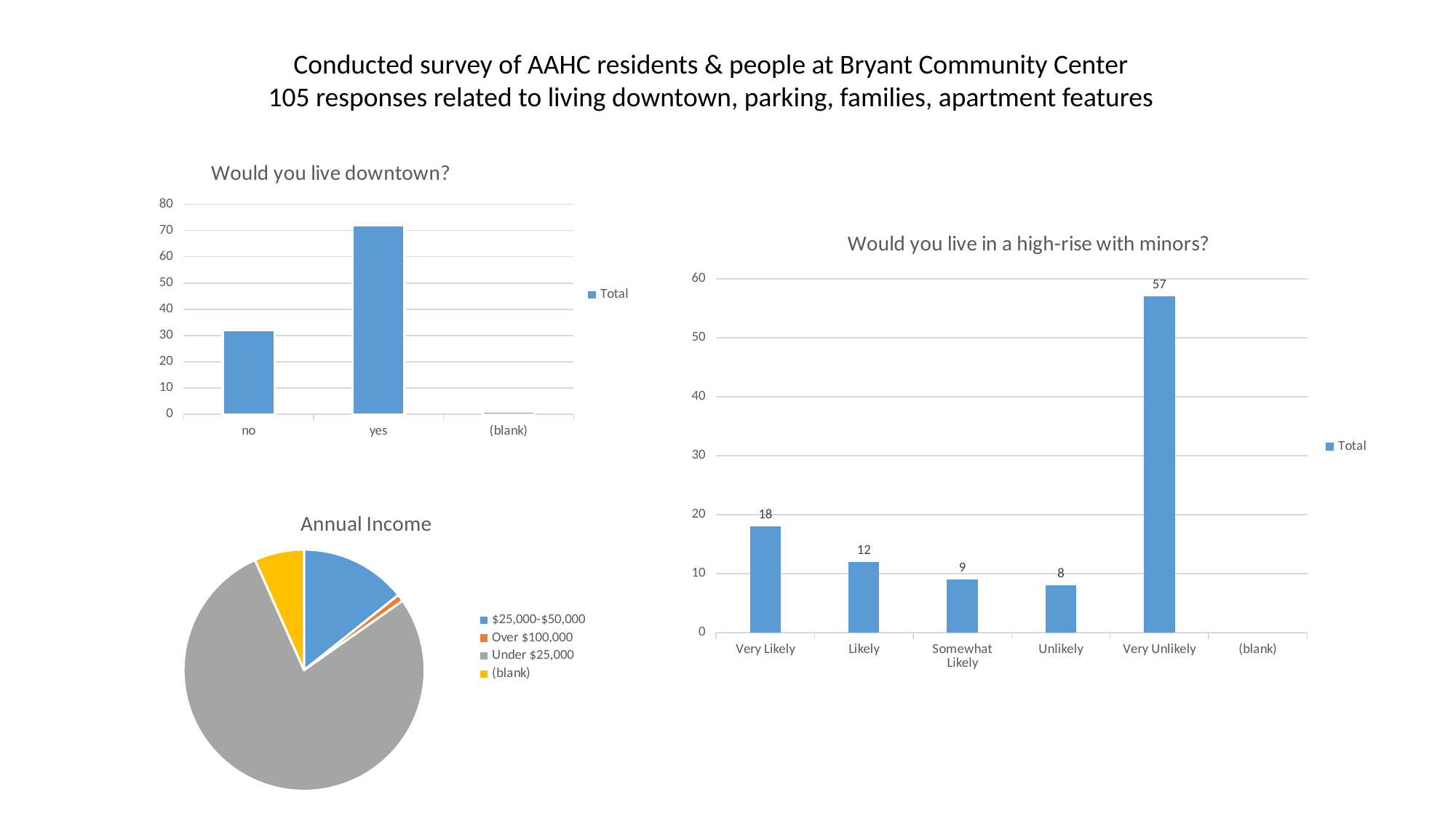
In the 'Would you live in a high-rise with minors?' chart, what is the value for Very Likely? 18 In the 'Would you live in a high-rise with minors?' chart, what is the value for Very Unlikely? 57 In the 'Would you live in a high-rise with minors?' chart, how many categories are shown on the x axis? 6 In the 'Would you live downtown?' chart, is the value for yes greater or less than 60? greater In the 'Would you live in a high-rise with minors?' chart, what is the value for Somewhat Likely? 9 In the 'Would you live downtown?' chart, which category has the highest value? yes In the 'Would you live in a high-rise with minors?' chart, which is larger, Somewhat Likely or Unlikely? Somewhat Likely What kind of chart is the 'Annual Income' chart? Pie chart In the 'Would you live downtown?' chart, is the value for no greater or less than 40? less In the 'Would you live in a high-rise with minors?' chart, what is the difference between Very Likely and Likely? 6 In the 'Would you live in a high-rise with minors?' chart, which category has the highest value? Very Unlikely How many entries does the legend of the 'Annual Income' chart list? 4